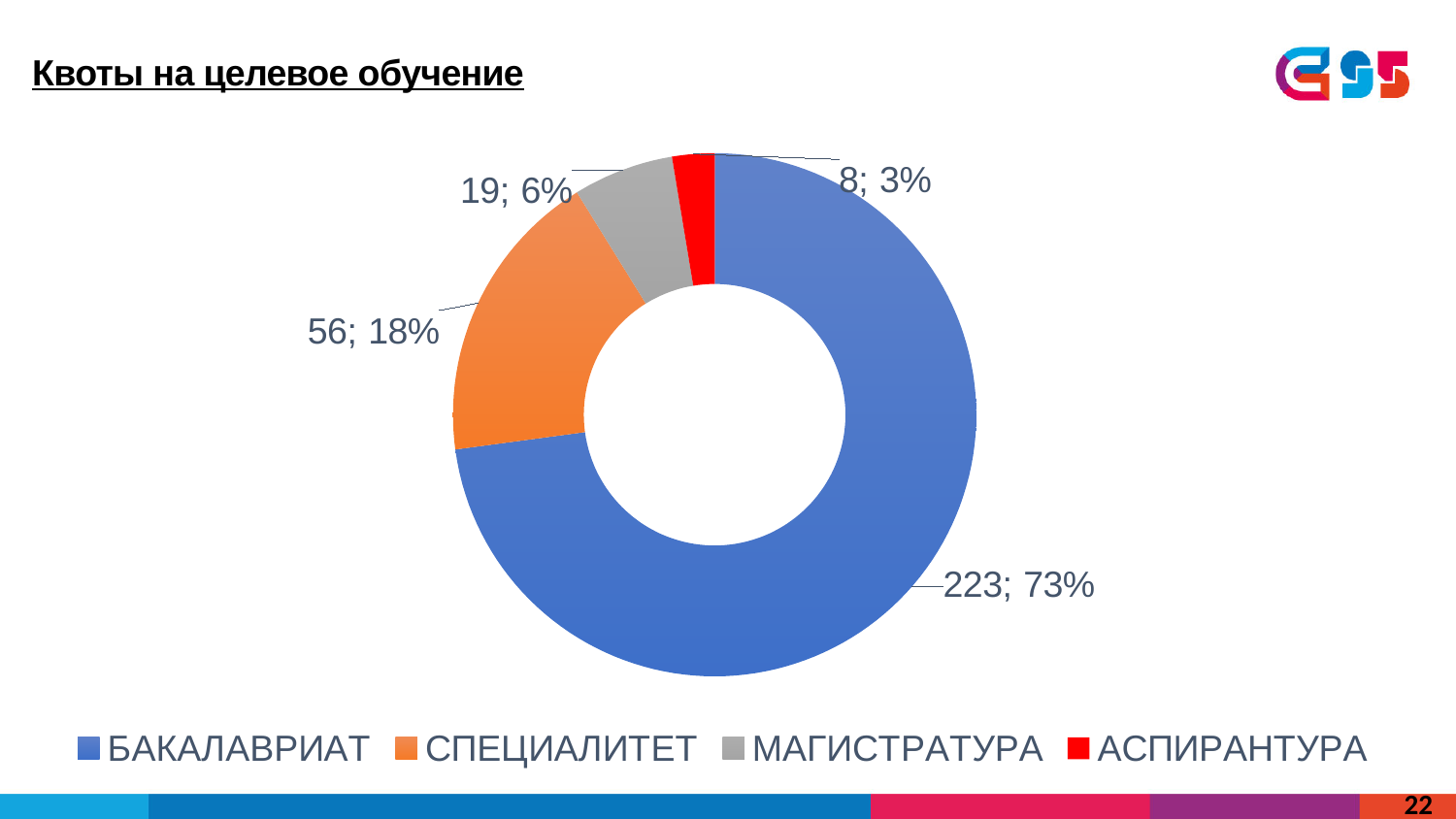
What share of the chart does СПЕЦИАЛИТЕТ represent? 18% What is the title of the slide? Квоты на целевое обучение Which category has the largest value? БАКАЛАВРИАТ What is the difference between the values for БАКАЛАВРИАТ and СПЕЦИАЛИТЕТ? 167 How many categories does the chart show? 4 What type of chart is shown on the slide? Doughnut chart What share of the chart does БАКАЛАВРИАТ represent? 73% What is the value for СПЕЦИАЛИТЕТ? 56 What is the value for АСПИРАНТУРА? 8 What is the value for МАГИСТРАТУРА? 19 Which category has the smallest value? АСПИРАНТУРА What is the value for БАКАЛАВРИАТ? 223